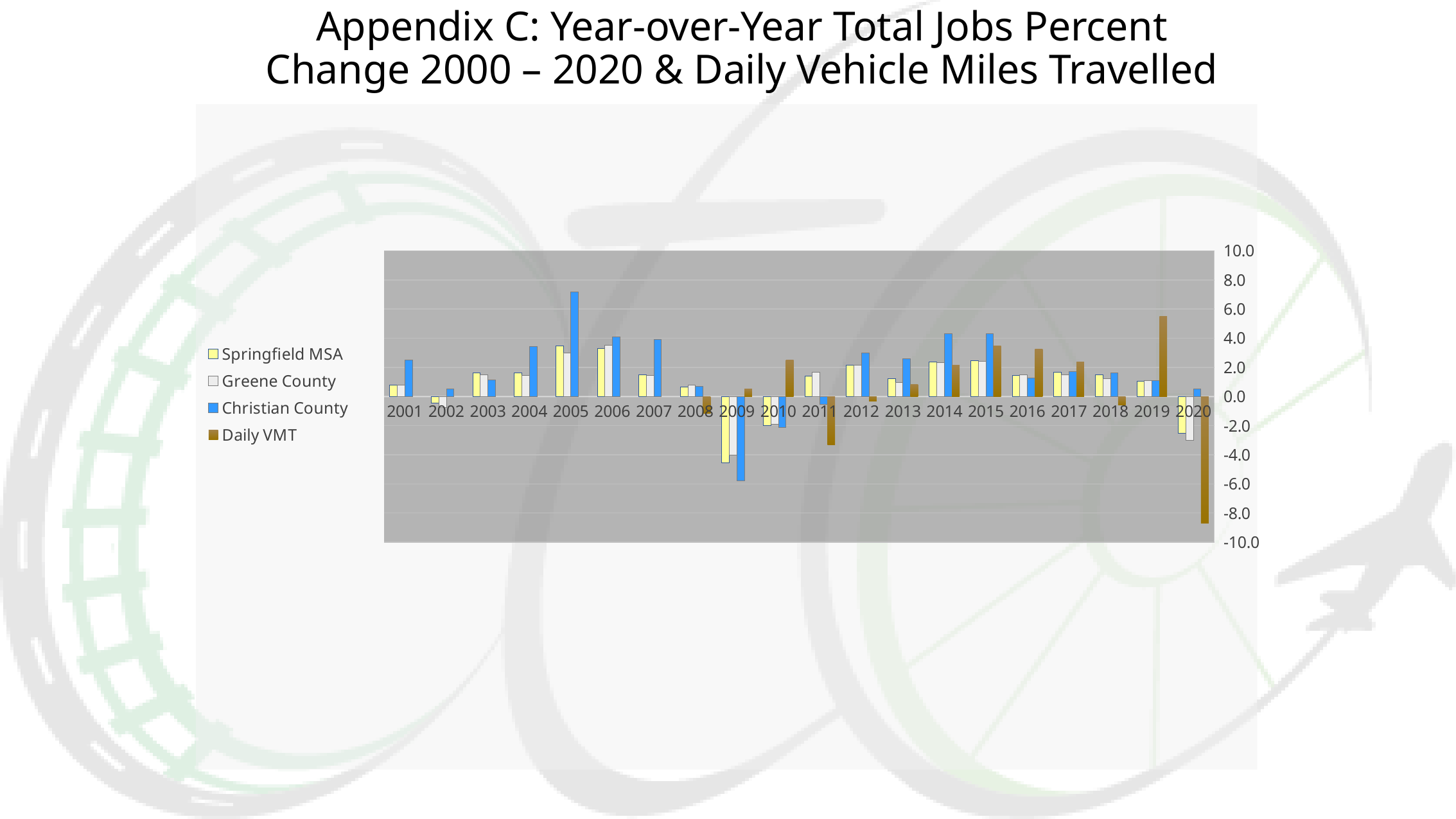
In which year is the Christian County value lowest? 2009 Is the Daily VMT value for 2019 greater or less than 4.0? greater What kind of chart is shown on the slide? bar chart In which year is the Christian County value highest? 2005 Which series is shown in blue in the legend? Christian County In 2005, which is larger: the Springfield MSA value or the Christian County value? Christian County How many years are shown along the x axis? 20 Is the Daily VMT value for 2020 greater or less than -8.0? less How many series does the legend list? 4 Is the Christian County value for 2009 greater or less than -4.0? less In which year is the Daily VMT value lowest? 2020